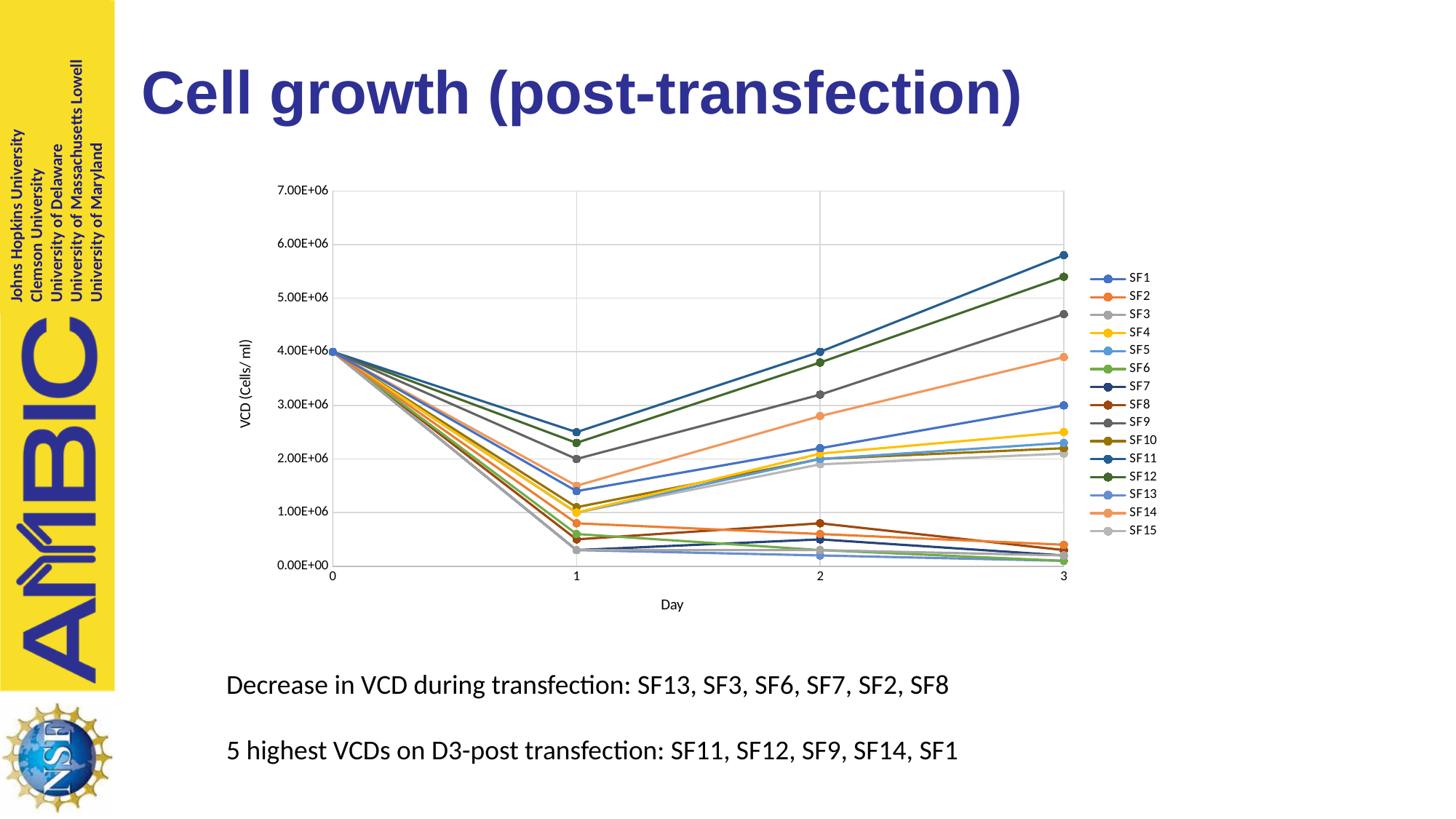
What is the VCD value for SF11 on Day 0? 4.00E+06 How many series does the legend list? 15 Which series has the highest VCD on Day 3? SF11 Is the value for SF14 on Day 2 greater or less than 3.00E+06? less Is the value for SF13 on Day 3 greater or less than 1.00E+06? less What is the label of the y axis? VCD (Cells/ ml) What type of chart is shown on the slide? line chart How many days (x-axis points) are plotted on the chart? 4 Is the value for SF11 on Day 3 greater or less than 5.00E+06? greater On Day 3, which series has the larger VCD, SF11 or SF1? SF11 Does the VCD for SF12 rise or fall from Day 1 to Day 3? rise